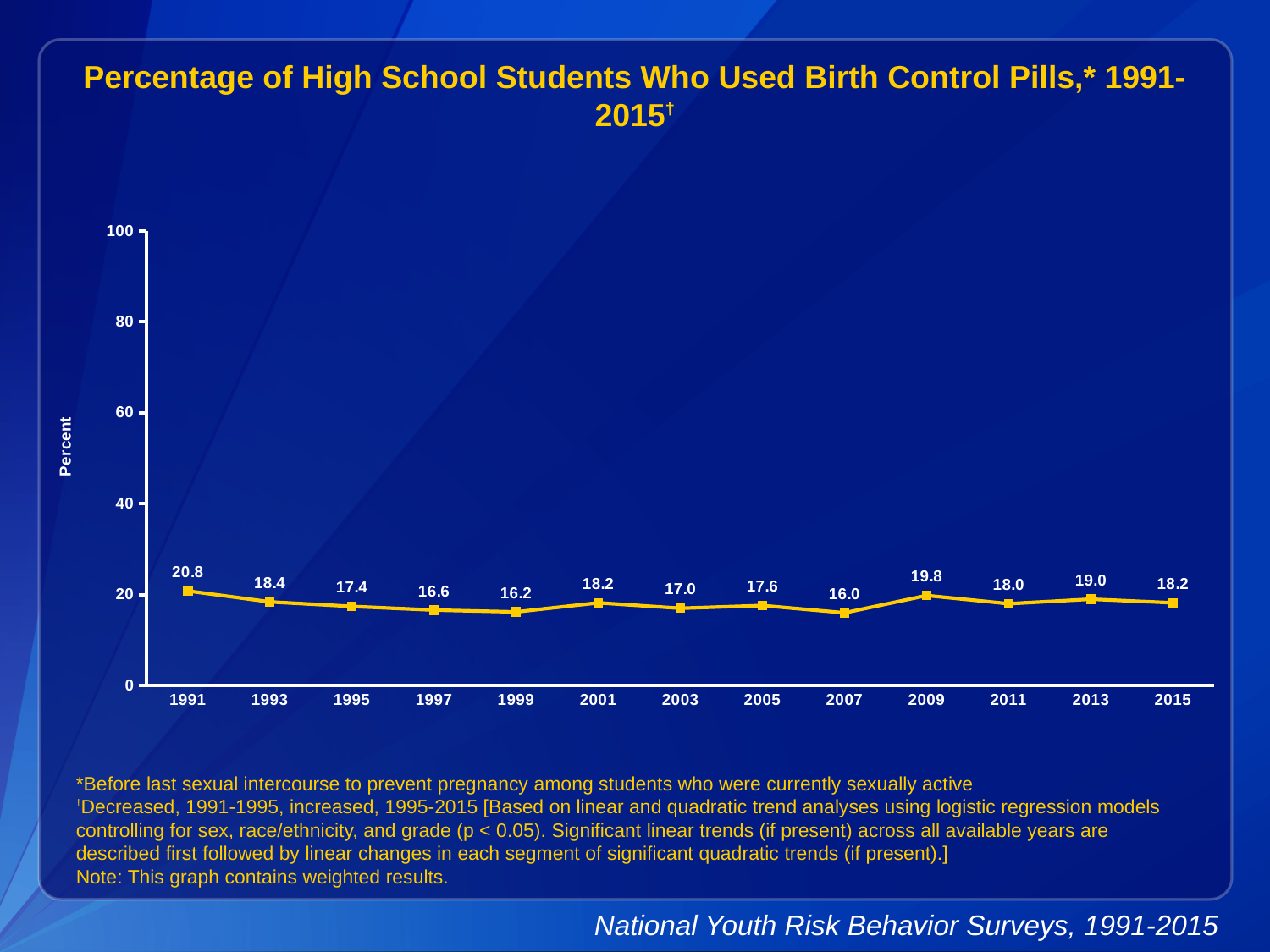
Is the value for 1991 greater or less than 20? greater Which year has the larger value, 2001 or 2003? 2001 What is the value plotted for 2009? 19.8 What is the label on the y axis? Percent Which year has the highest value on the chart? 1991 Which year has the lowest value on the chart? 2007 What kind of chart is shown on the slide? line chart Did the value rise or fall from 1991 to 1999? fall How many years are plotted on the x axis? 13 What is the difference between the 1991 value and the 2007 value? 4.8 What percentage of high school students used birth control pills in 1991? 20.8 What is the value plotted for 2015? 18.2